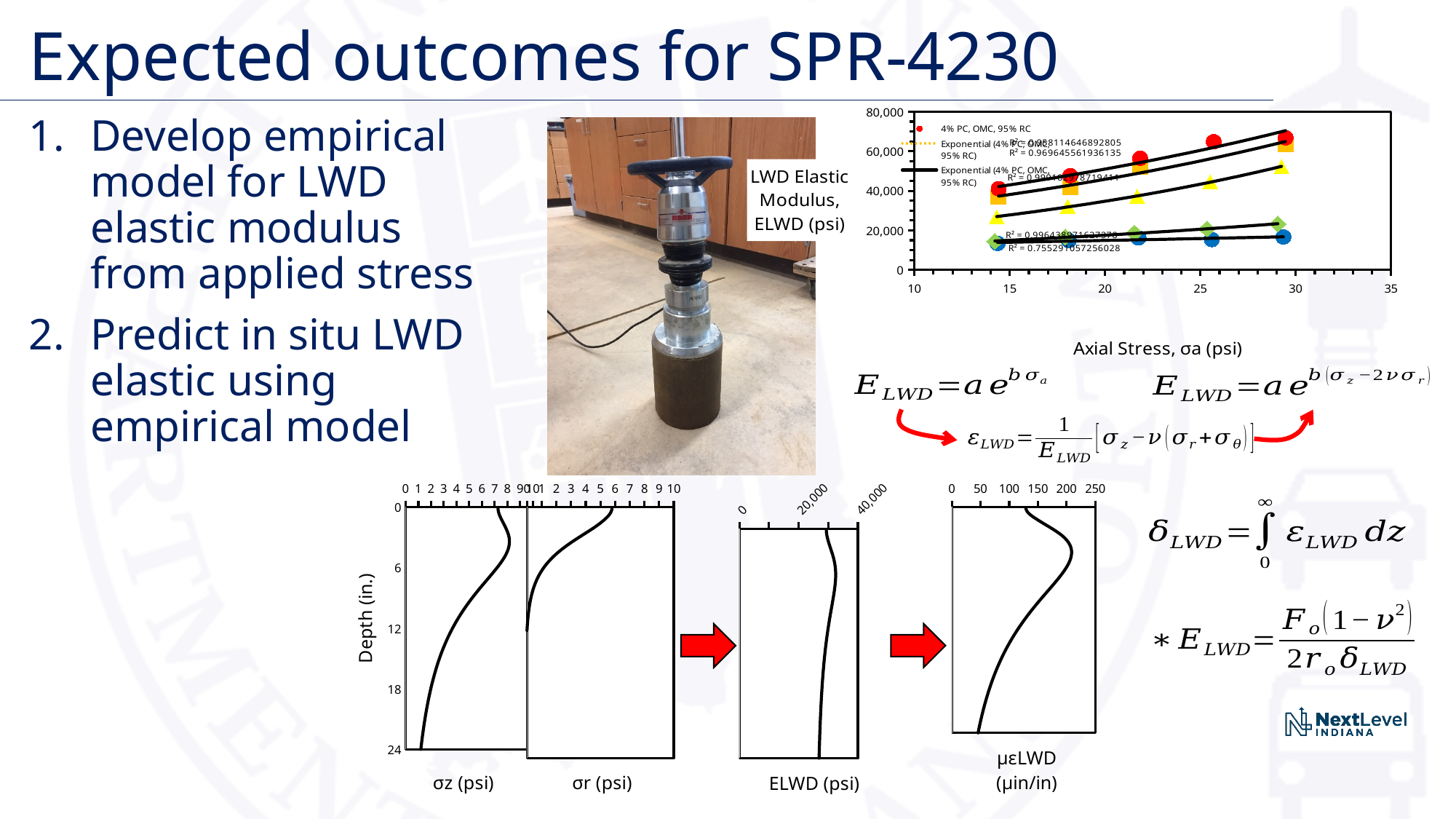
In the top-right chart, do the plotted LWD elastic modulus values rise or fall as axial stress increases? rise In the bottom depth-profile charts, what is the largest depth value shown on the Depth (in.) axis? 24 In the top-right chart, what is the label of the y axis? LWD Elastic Modulus, ELWD (psi) In the top-right chart, which marker colour series has the highest LWD elastic modulus values? red In the top-right chart, is the blue series value at an axial stress of about 14 psi greater or less than 20,000? less In the bottom μεLWD (μin/in) chart, what is the highest value shown on the horizontal axis? 250 In the top-right chart, what is the highest value shown on the x axis? 35 In the top-right chart, what is the highest value shown on the y axis? 80,000 In the top-right chart, what is the label of the x axis? Axial Stress, σa (psi) In the top-right chart, is the red series value at an axial stress of about 29 psi greater or less than 60,000? greater In the top-right chart, what is the smallest R² value printed? 0.755291057256028 In the top-right chart, which marker colour series has the lowest LWD elastic modulus values? blue